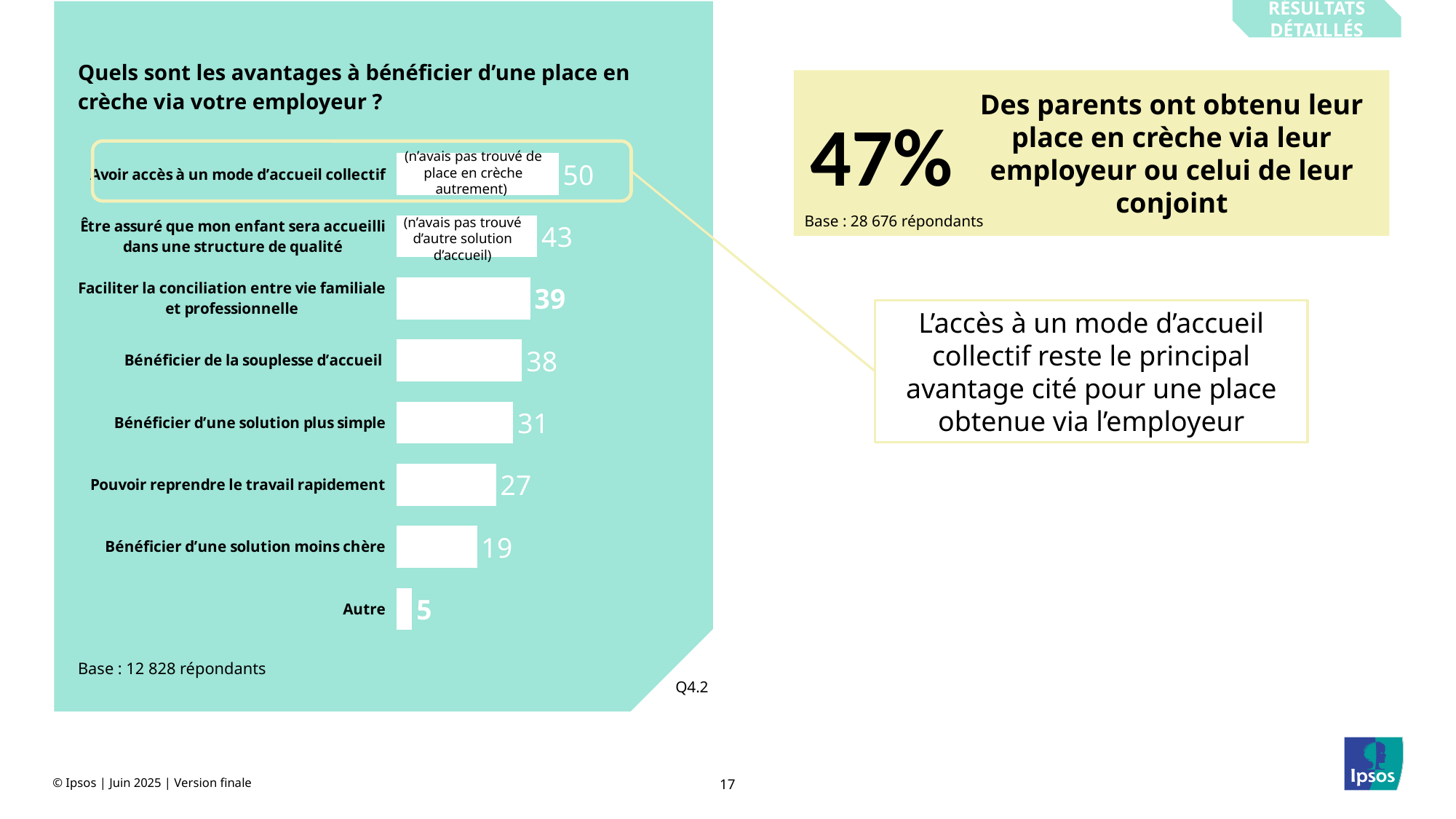
What is the value for 'Avoir accès à un mode d'accueil collectif'? 50 What is the difference between 'Bénéficier d'une solution plus simple' and 'Bénéficier d'une solution moins chère'? 12 Which category has the highest value? Avoir accès à un mode d'accueil collectif What is the base (number of respondents) stated for the chart? 12 828 répondants What is the value for 'Pouvoir reprendre le travail rapidement'? 27 Which is larger: 'Faciliter la conciliation entre vie familiale et professionnelle' or 'Bénéficier de la souplesse d'accueil'? Faciliter la conciliation entre vie familiale et professionnelle What is the value for 'Autre'? 5 What is the value for 'Bénéficier de la souplesse d'accueil'? 38 Which category has the lowest value? Autre What is the difference between 'Avoir accès à un mode d'accueil collectif' and 'Être assuré que mon enfant sera accueilli dans une structure de qualité'? 7 How many categories are shown in the chart? 8 What kind of chart is shown on the slide? Bar chart